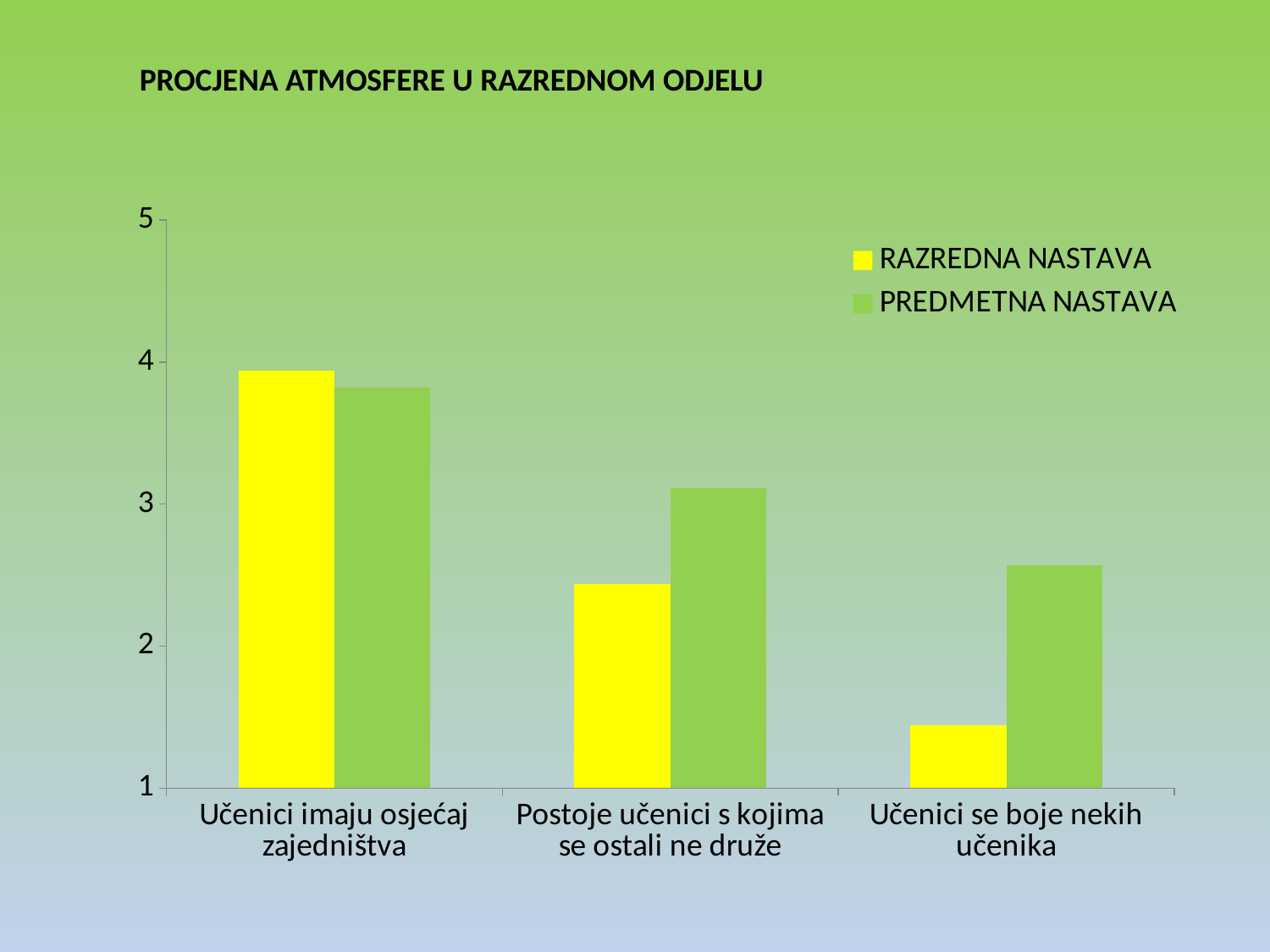
For the category 'Postoje učenici s kojima se ostali ne druže', which series has the larger value? PREDMETNA NASTAVA What kind of chart is shown on the slide? bar chart How many categories are shown on the x axis of the chart? 3 Do the RAZREDNA NASTAVA values rise or fall from left to right across the categories? fall For which category is the PREDMETNA NASTAVA value lowest? Učenici se boje nekih učenika Which series is shown in yellow? RAZREDNA NASTAVA Is the PREDMETNA NASTAVA value for 'Učenici se boje nekih učenika' greater or less than 2? greater For which category is the RAZREDNA NASTAVA value lowest? Učenici se boje nekih učenika How many series does the legend list? 2 What is the title of the chart? PROCJENA ATMOSFERE U RAZREDNOM ODJELU For which category is the RAZREDNA NASTAVA value highest? Učenici imaju osjećaj zajedništva Is the RAZREDNA NASTAVA value for 'Učenici se boje nekih učenika' greater or less than 2? less